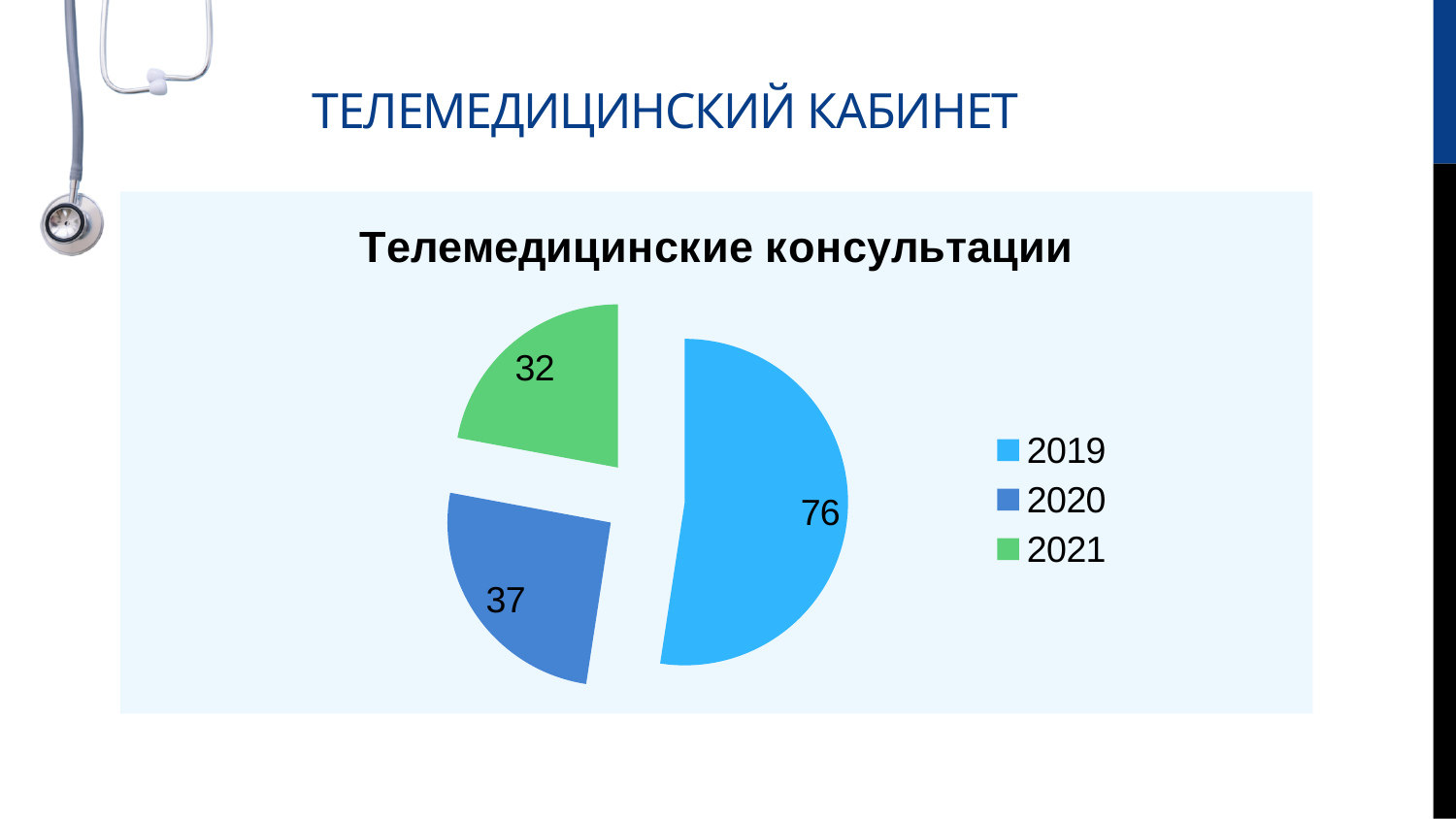
Which year has the largest slice? 2019 How many entries does the legend list? 3 What type of chart is shown on the slide? Pie chart What is the title of the chart? Телемедицинские консультации What is the difference between the values for 2019 and 2020? 39 What is the value for 2021? 32 What is the value for 2019? 76 What is the value for 2020? 37 How many slices does the pie chart have? 3 Which is larger, the value for 2019 or the value for 2021? 2019 Which year has the smallest slice? 2021 What is the difference between the values for 2020 and 2021? 5